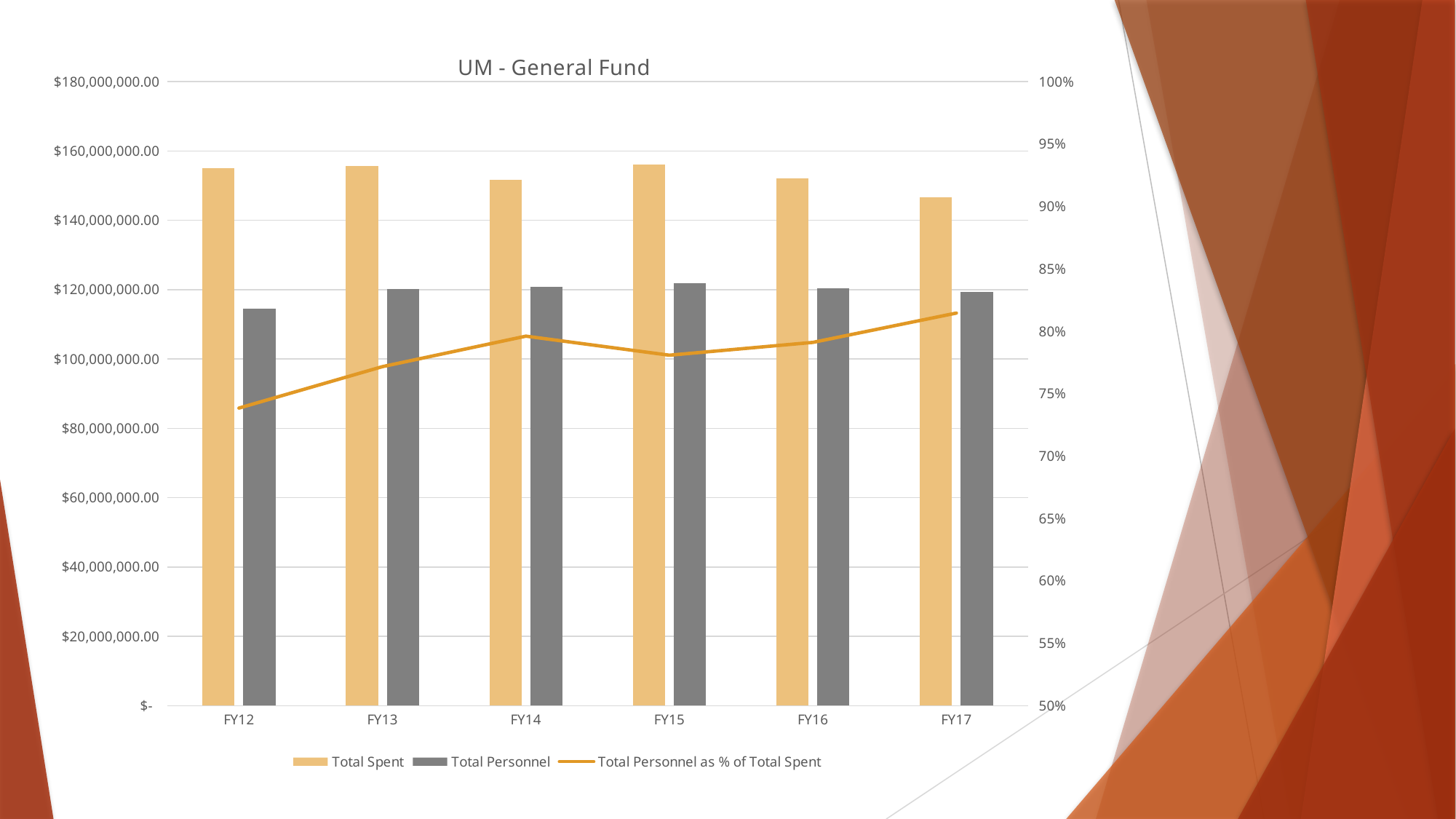
Is the Total Spent value for FY12 greater or less than $140,000,000.00? greater Which fiscal year has the lowest Total Personnel? FY12 Is the Total Personnel as % of Total Spent value for FY17 greater or less than 80%? greater How many series does the legend list? 3 Which fiscal year has the highest Total Personnel as % of Total Spent? FY17 How many fiscal years are shown on the x axis? 6 Which is larger, Total Spent in FY12 or Total Spent in FY17? FY12 What kind of chart is this? Combined bar and line chart Is the Total Personnel value for FY12 greater or less than $120,000,000.00? less What is the title of the chart? UM - General Fund Which fiscal year has the lowest Total Spent? FY17